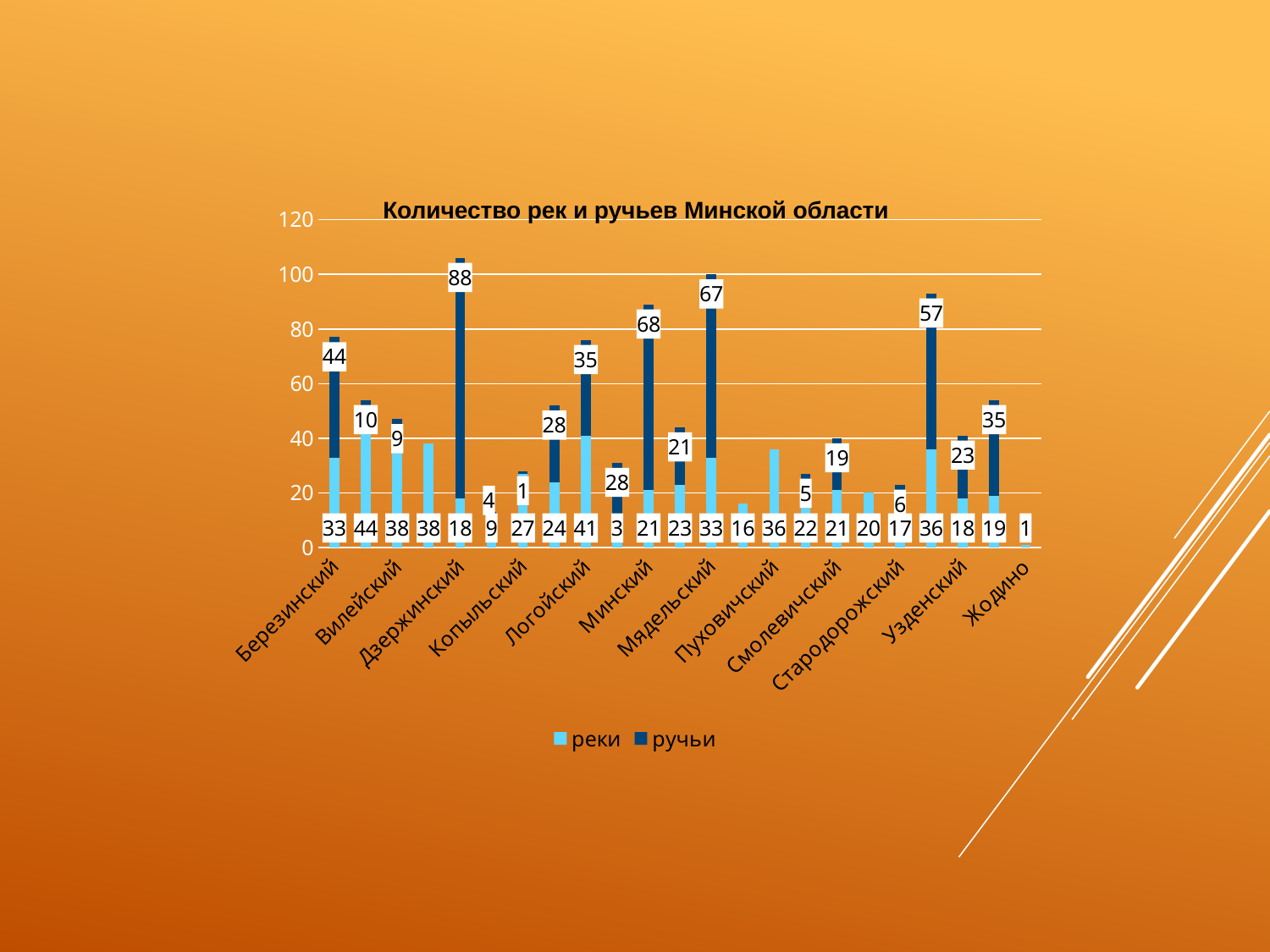
What is the value of реки for Жодино? 1 Is the total stacked bar for Дзержинский greater or less than 100? greater Which is larger for Березинский, реки or ручьи? ручьи What are the two series named in the legend? реки and ручьи What is the total of the stacked bar for Мядельский (реки plus ручьи)? 100 What is the value of реки for Логойский? 41 What is the title of the chart? Количество рек и ручьев Минской области What is the value of ручьи for Дзержинский? 88 What is the difference between ручьи and реки for Минский? 47 What kind of chart is shown on the slide? stacked bar chart How many series does the legend list? 2 Which labelled district has the highest value of ручьи? Дзержинский